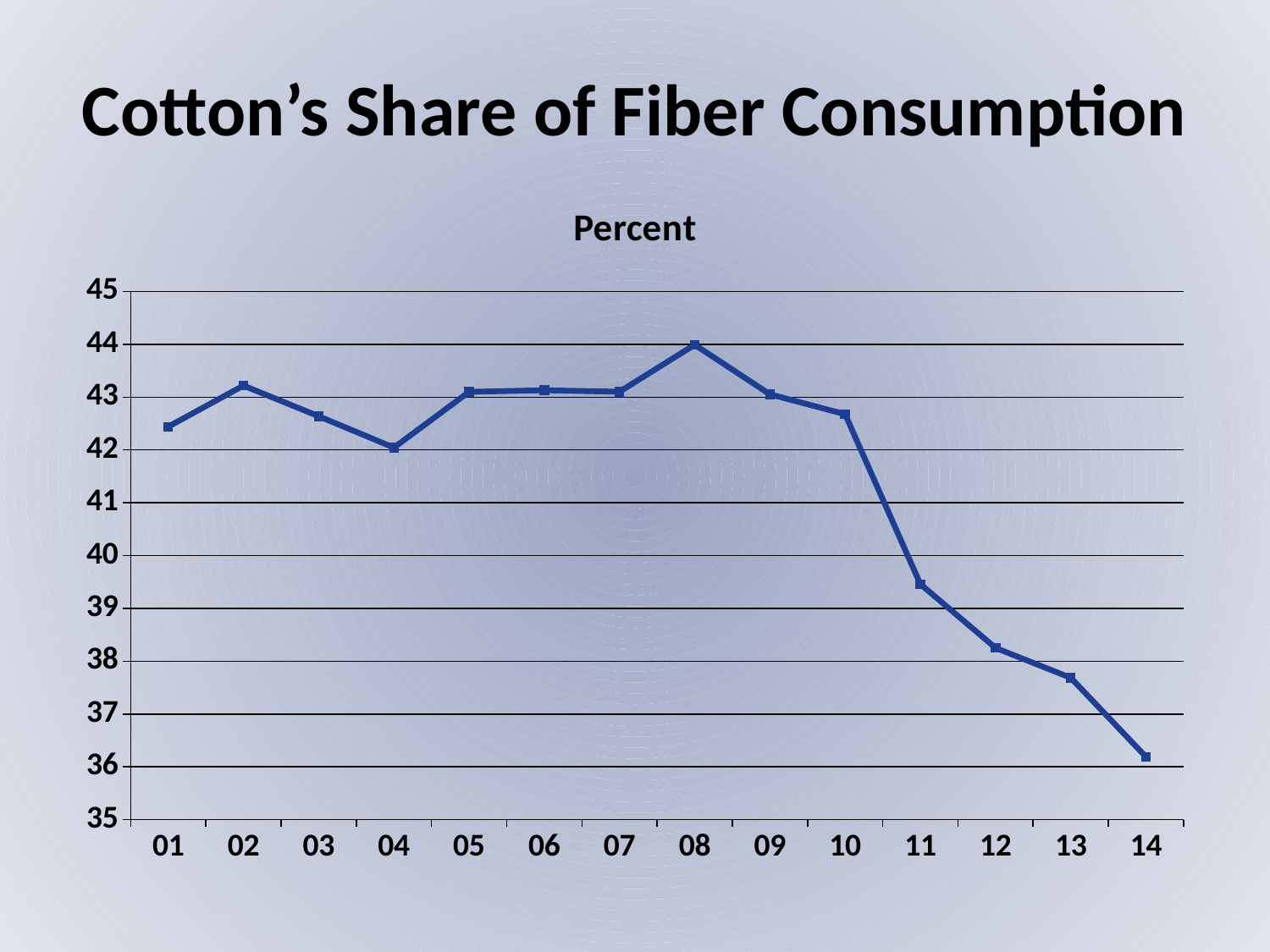
How many years are plotted along the x axis? 14 Is the value for 14 greater or less than 37? less Do the values rise or fall from 10 to 14? fall In which year is cotton's share of fiber consumption highest? 08 Is the value for 11 greater or less than 40? less Is the value for 08 greater or less than 43? greater What unit label appears above the chart? Percent Which year has the larger value, 11 or 12? 11 What is the title of the slide? Cotton's Share of Fiber Consumption In which year is cotton's share of fiber consumption lowest? 14 What kind of chart is shown on the slide? line chart